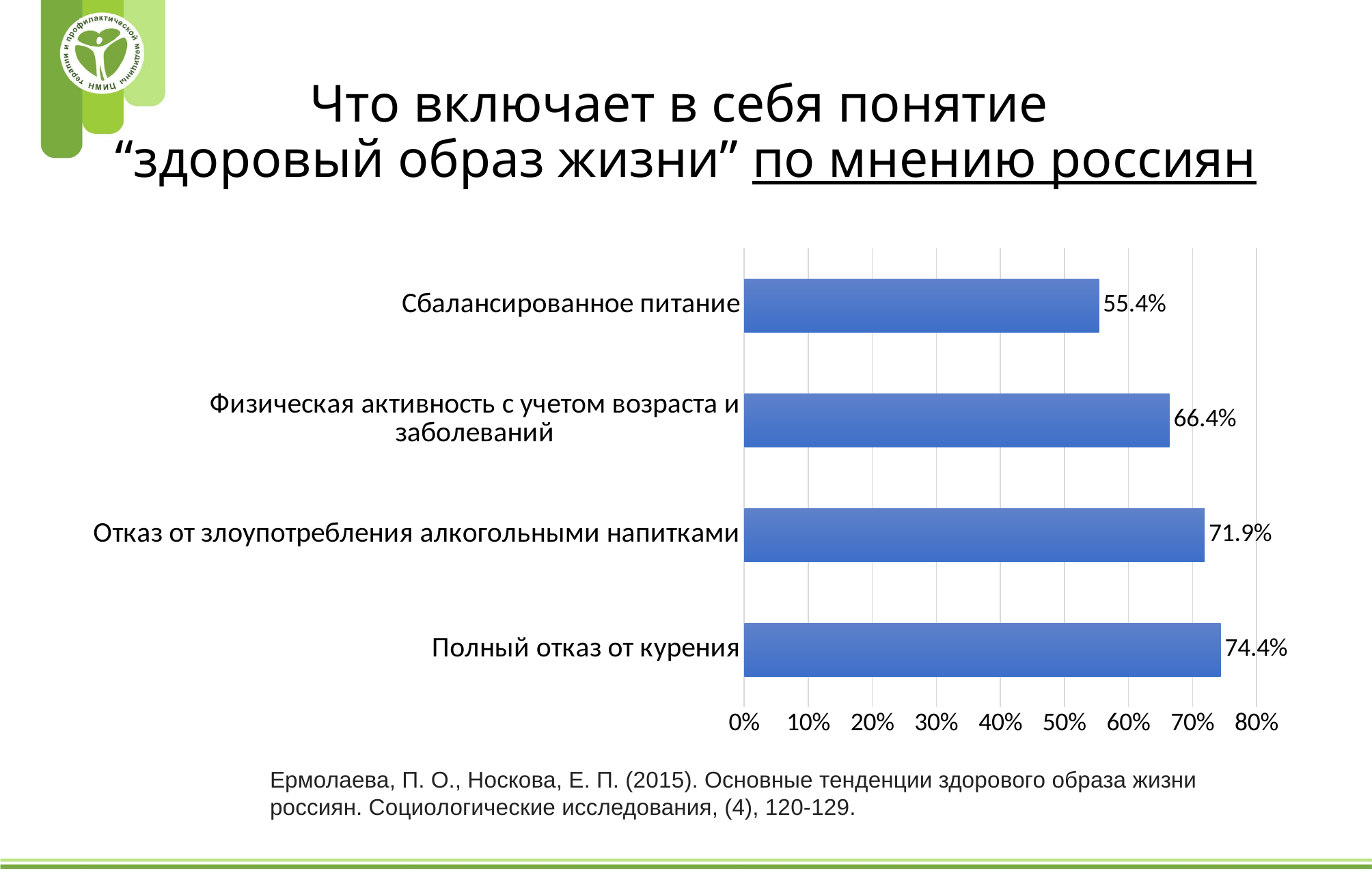
What is the value for "Отказ от злоупотребления алкогольными напитками"? 71.9% What is the value for "Физическая активность с учетом возраста и заболеваний"? 66.4% What is the maximum value shown on the horizontal axis of the chart? 80% What is the value for "Полный отказ от курения"? 74.4% What is the value for "Сбалансированное питание"? 55.4% Which category has the highest value? Полный отказ от курения Which category has the lowest value? Сбалансированное питание What is the difference between the values for "Отказ от злоупотребления алкогольными напитками" and "Физическая активность с учетом возраста и заболеваний"? 5.5% What is the difference between the values for "Полный отказ от курения" and "Сбалансированное питание"? 19.0% What type of chart is shown on the slide? Bar chart How many categories are shown in the chart? 4 Which is larger: the value for "Физическая активность с учетом возраста и заболеваний" or the value for "Сбалансированное питание"? Физическая активность с учетом возраста и заболеваний